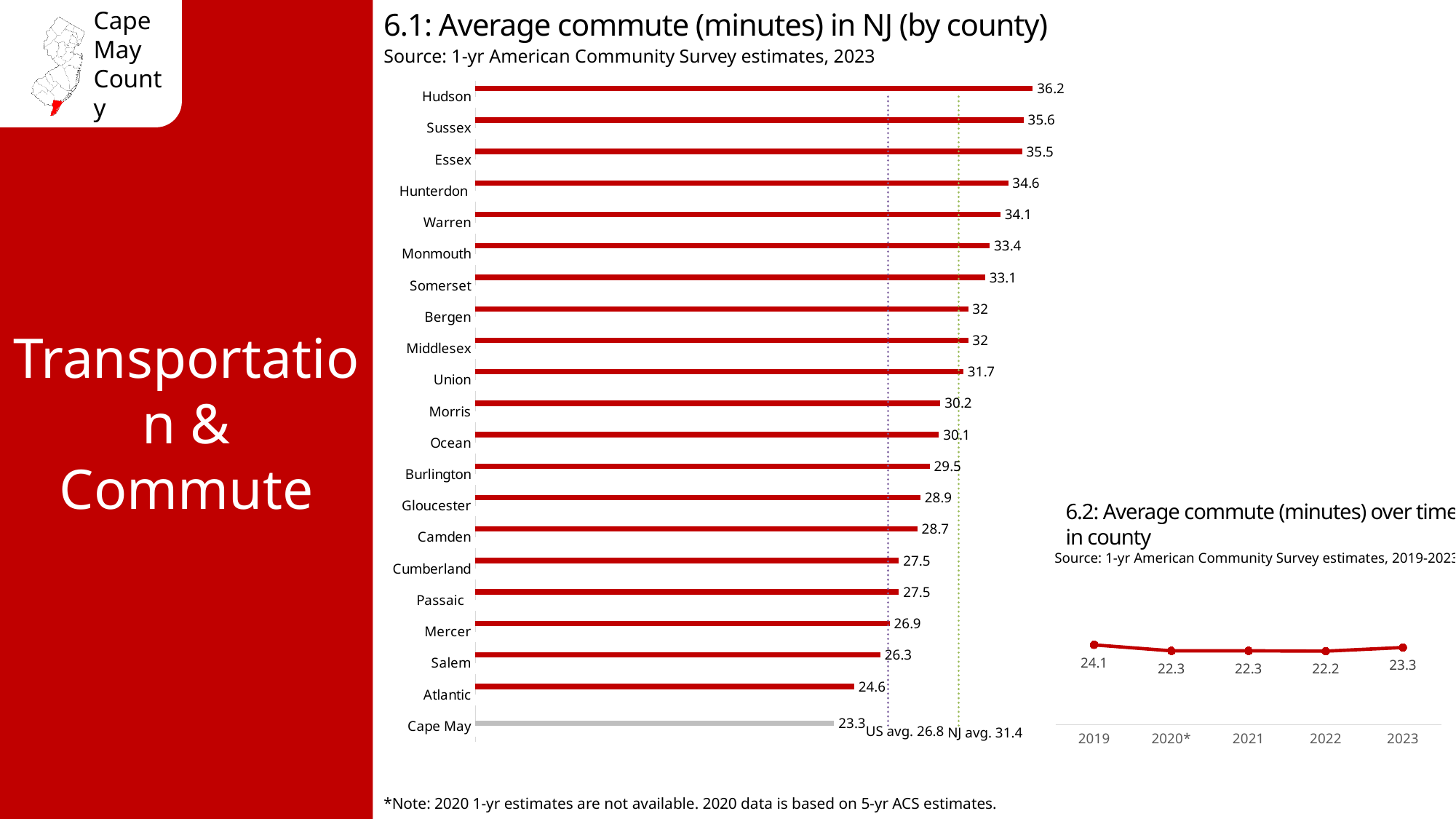
In chart 6.2 (Average commute over time in county), what is the value for 2019? 24.1 In chart 6.1 (Average commute in NJ by county), what is the average commute for Cape May? 23.3 In chart 6.1 (Average commute in NJ by county), which county has the lowest average commute? Cape May What type of chart is chart 6.1 (Average commute in NJ by county)? Bar chart In chart 6.1 (Average commute in NJ by county), what is the NJ average commute shown by the reference line? 31.4 In chart 6.2 (Average commute over time in county), how many data points are plotted? 5 In chart 6.2 (Average commute over time in county), which year has the lowest value? 2022 In chart 6.1 (Average commute in NJ by county), what is the difference between Hudson's and Cape May's average commute? 12.9 In chart 6.1 (Average commute in NJ by county), which county has the highest average commute? Hudson In chart 6.1 (Average commute in NJ by county), what is the average commute for Hudson? 36.2 In chart 6.1 (Average commute in NJ by county), which has a longer average commute, Morris or Ocean? Morris In chart 6.1 (Average commute in NJ by county), how many counties are plotted? 21